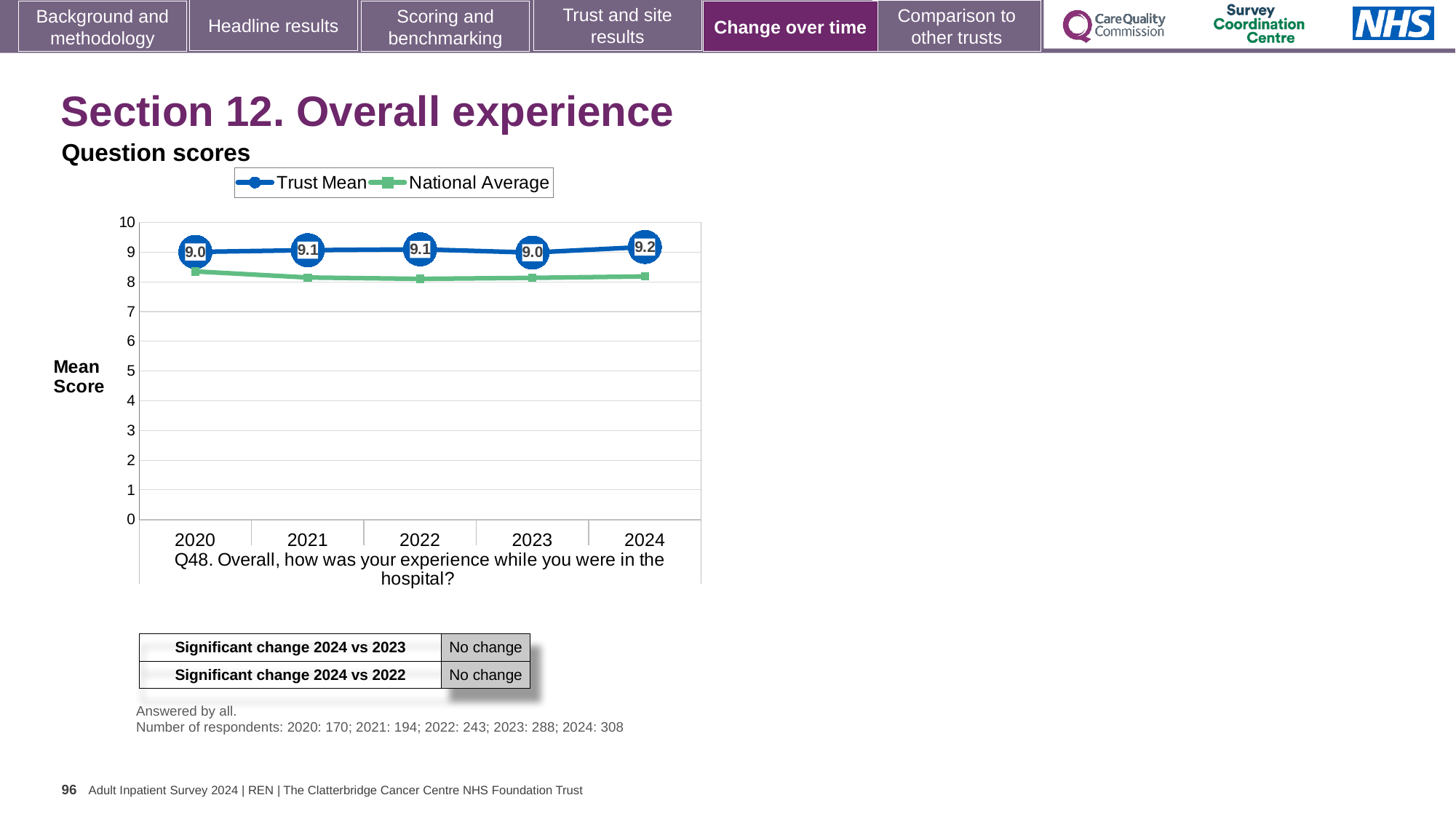
What is the Trust Mean value for 2020? 9.0 Is the National Average value for 2020 greater or less than 8? greater What is the Trust Mean value for 2022? 9.1 How many series does the legend list? 2 How many years are plotted on the x axis? 5 In which year is the Trust Mean highest? 2024 What is the difference between the Trust Mean in 2021 and in 2023? 0.1 In 2024, which is larger: the Trust Mean or the National Average? Trust Mean What is the difference between the Trust Mean in 2024 and in 2020? 0.2 What kind of chart is shown on the slide? Line chart What is the Trust Mean value for 2024? 9.2 Is the National Average value for 2022 greater or less than 9? less